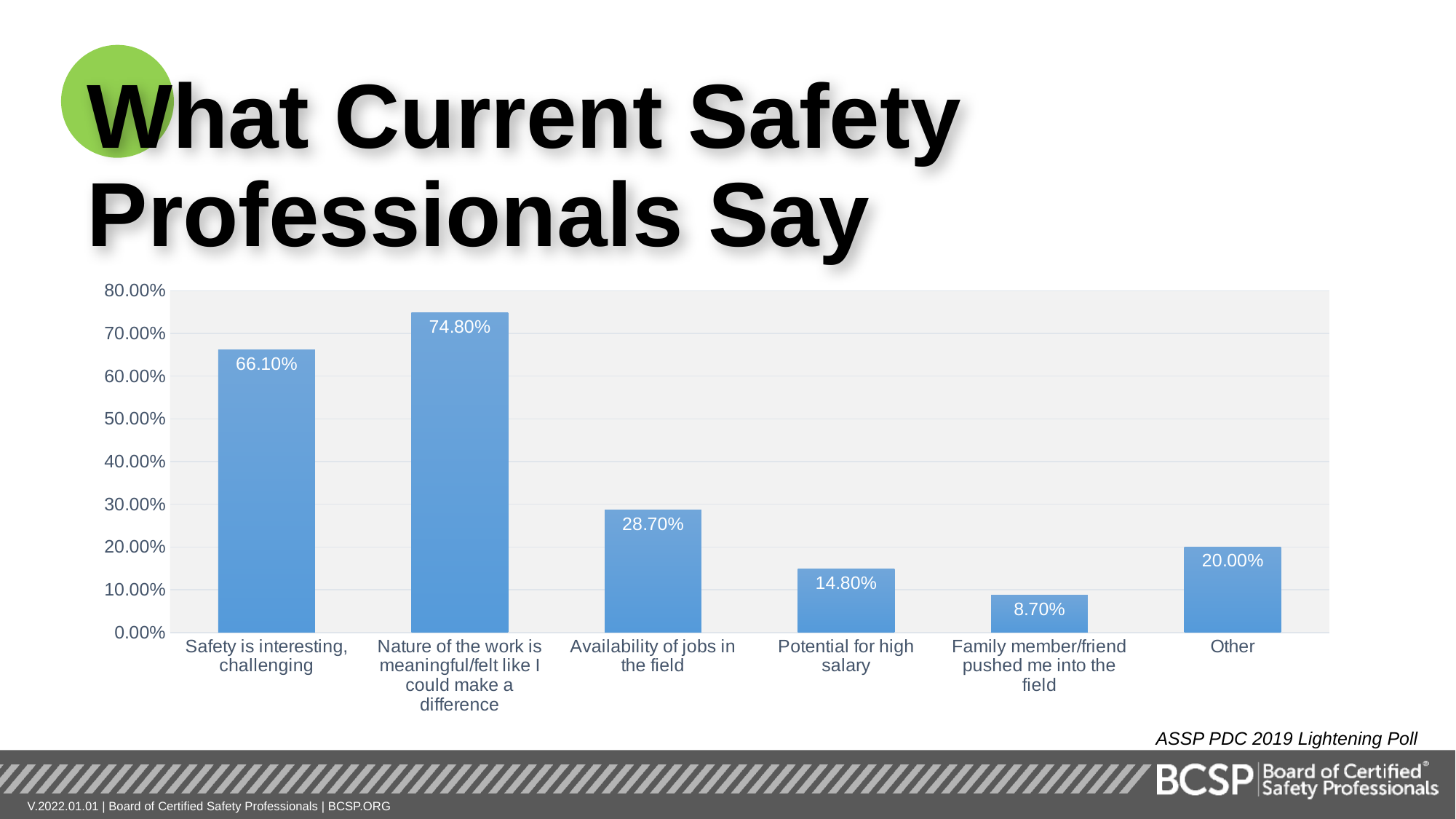
Which category has the lowest value? Family member/friend pushed me into the field How many categories are shown in the chart? 6 What is the difference between the values for "Nature of the work is meaningful/felt like I could make a difference" and "Safety is interesting, challenging"? 8.70% Is the value for "Family member/friend pushed me into the field" greater or less than 10.00%? less What is the value for "Potential for high salary"? 14.80% What is the value for "Safety is interesting, challenging"? 66.10% What is the source cited for the chart data? ASSP PDC 2019 Lightening Poll What is the difference between the values for "Availability of jobs in the field" and "Other"? 8.70% What is the value for "Other"? 20.00% Which category has the highest value? Nature of the work is meaningful/felt like I could make a difference What kind of chart is shown on the slide? Bar chart Which is larger, the value for "Availability of jobs in the field" or the value for "Other"? Availability of jobs in the field